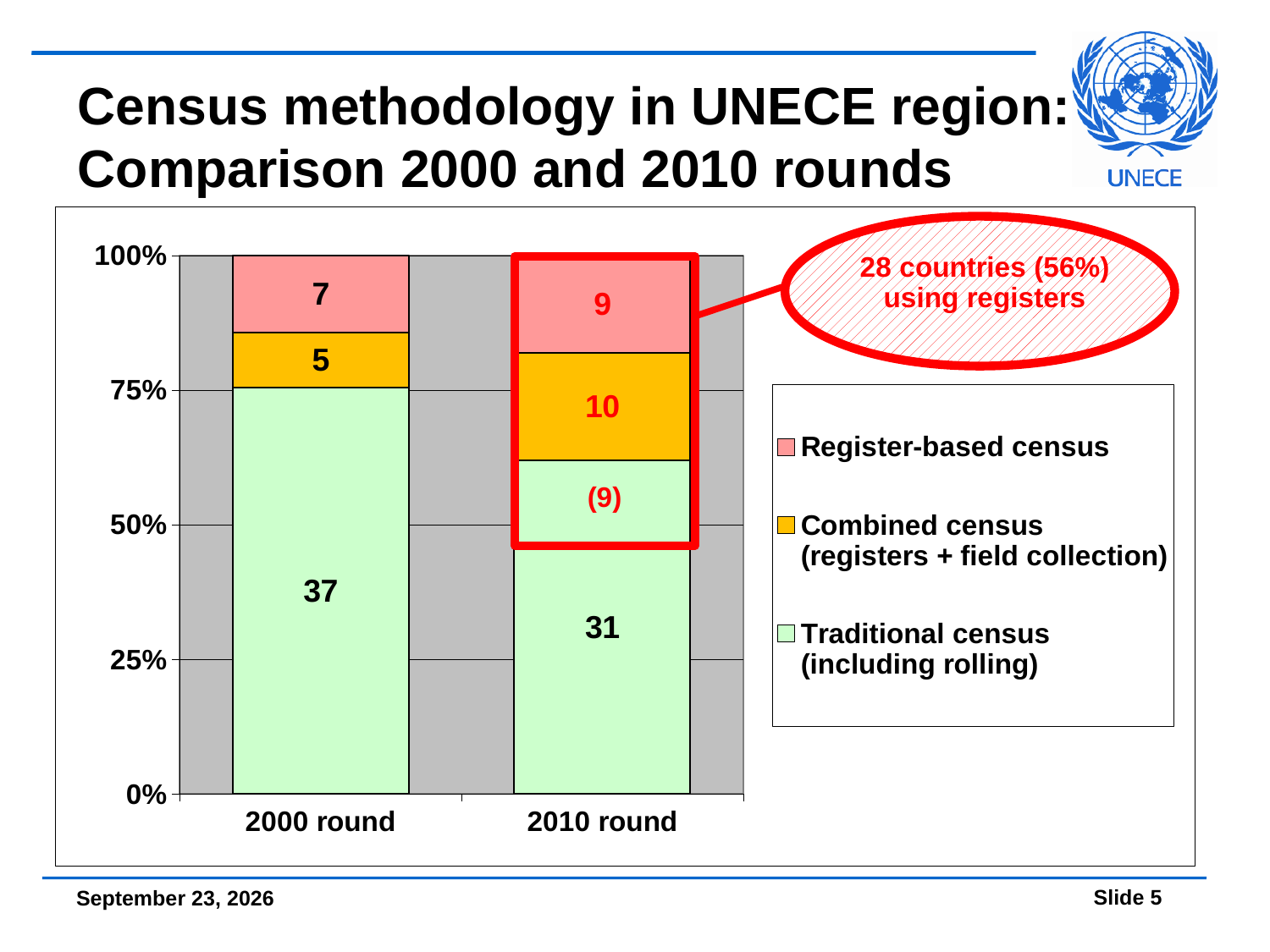
What is the value for Register-based census in the 2000 round? 7 What is the value for Traditional census (including rolling) in the 2010 round? 31 What is the value for Combined census (registers + field collection) in the 2010 round? 10 What is the total of the labelled segments in the 2000 round bar? 49 What kind of chart is shown on the slide? Stacked bar chart What is the value for Traditional census (including rolling) in the 2000 round? 37 How many rounds (categories) are shown on the x axis? 2 Which round has the larger value for Register-based census, 2000 or 2010? 2010 round What is the value for Combined census in the 2000 round? 5 How many series does the legend list? 3 What is the value for Register-based census in the 2010 round? 9 By how much did the Combined census value increase from the 2000 round to the 2010 round? 5